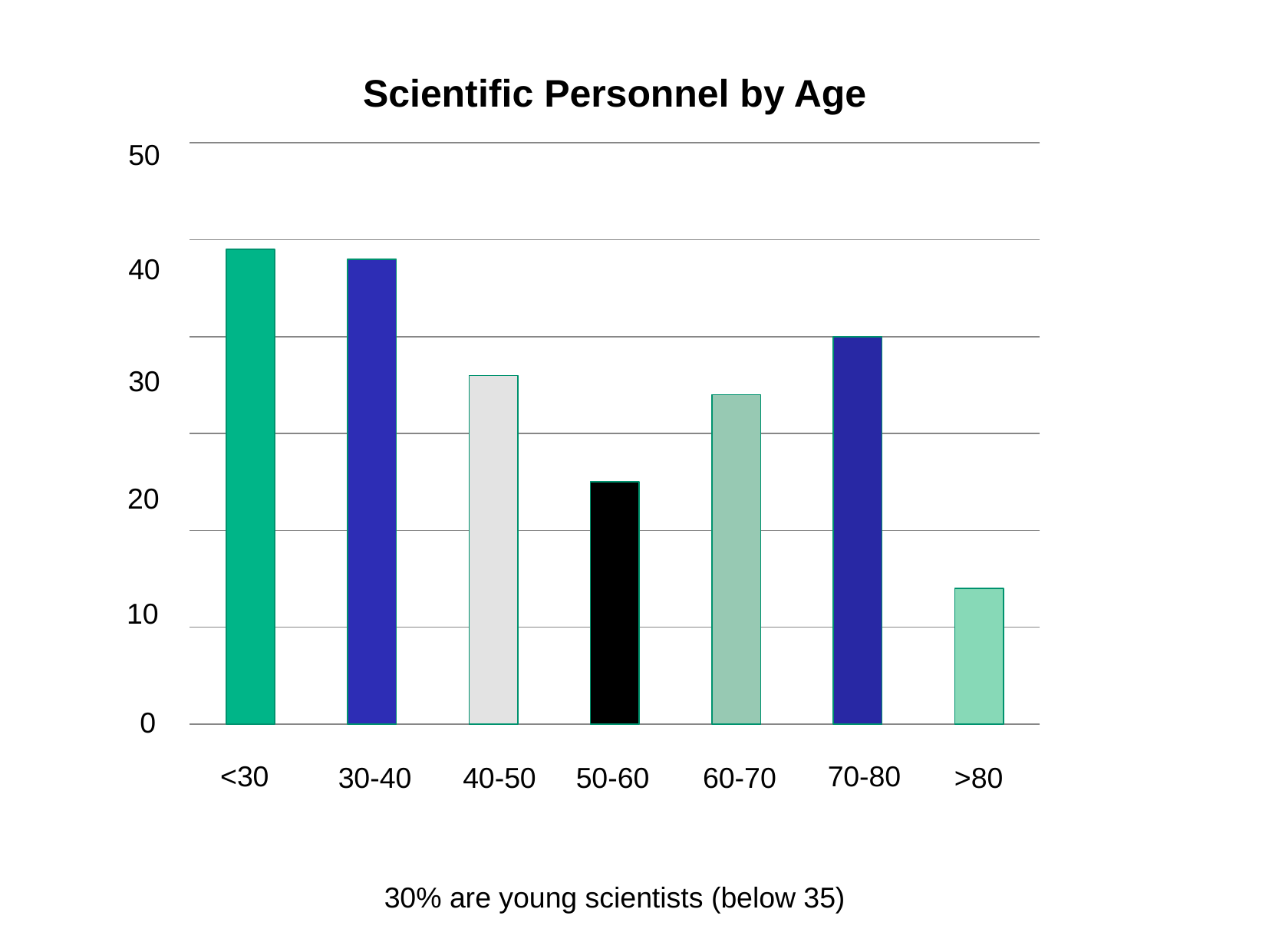
Which age category has the lowest value? >80 What does the text below the chart say? 30% are young scientists (below 35) Is the value for 60-70 greater or less than 40? less What is the title of the chart? Scientific Personnel by Age Which is larger, the value for 70-80 or the value for 60-70? 70-80 Is the value for >80 greater or less than 20? less Is the value for <30 greater or less than 30? greater Which is larger, the value for 40-50 or the value for 50-60? 40-50 What kind of chart is shown on the slide? bar chart How many age categories are shown on the x axis? 7